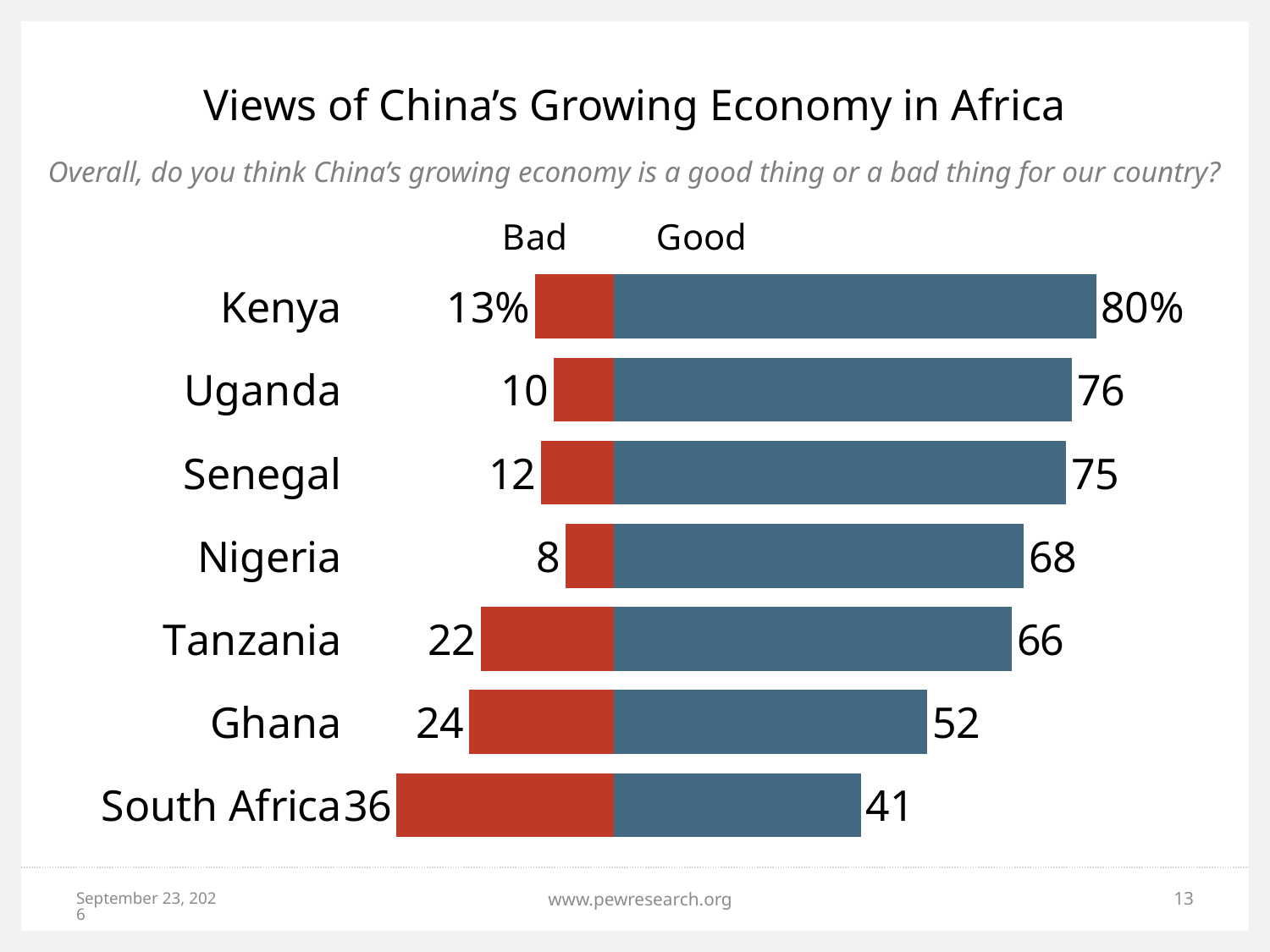
Which is larger, the 'Bad' value for Tanzania or the 'Bad' value for Ghana? Ghana How many countries are shown in the chart? 7 What is the difference between the 'Good' values for Uganda and Tanzania? 10 What is the 'Bad' value for South Africa? 36 Which country has the lowest 'Good' value? South Africa Which country has the lowest 'Bad' value? Nigeria Which country has the highest 'Good' value? Kenya What kind of chart is shown on the slide? Bar chart How many series does the chart show? 2 What is the 'Good' value for Ghana? 52 What percentage of respondents in Kenya say China's growing economy is a good thing? 80% What colour are the 'Bad' bars? Red